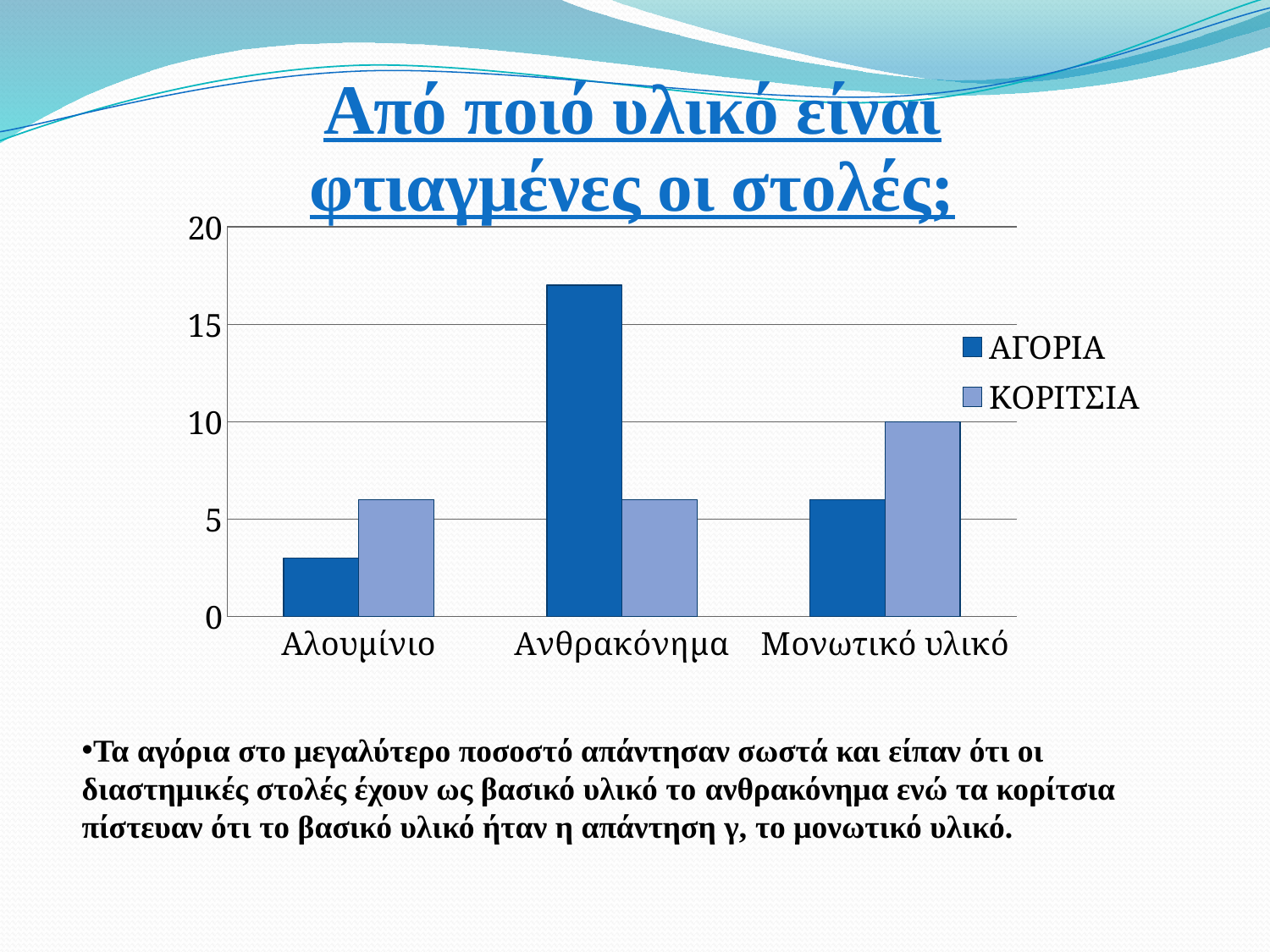
Which category has the lowest value for ΑΓΟΡΙΑ? Αλουμίνιο Which category has the highest value for ΚΟΡΙΤΣΙΑ? Μονωτικό υλικό What are the two entries listed in the chart's legend? ΑΓΟΡΙΑ and ΚΟΡΙΤΣΙΑ Is the value for ΑΓΟΡΙΑ in the Ανθρακόνημα category greater or less than 15? greater Which category has the highest value for ΑΓΟΡΙΑ? Ανθρακόνημα In the Ανθρακόνημα category, which series has the larger value, ΑΓΟΡΙΑ or ΚΟΡΙΤΣΙΑ? ΑΓΟΡΙΑ Is the value for ΑΓΟΡΙΑ in the Αλουμίνιο category greater or less than 5? less In the Μονωτικό υλικό category, which series has the larger value, ΑΓΟΡΙΑ or ΚΟΡΙΤΣΙΑ? ΚΟΡΙΤΣΙΑ What kind of chart is shown on the slide? bar chart How many series does the chart's legend list? 2 What is the value for ΚΟΡΙΤΣΙΑ in the Μονωτικό υλικό category? 10 How many categories are shown on the x axis of the chart? 3